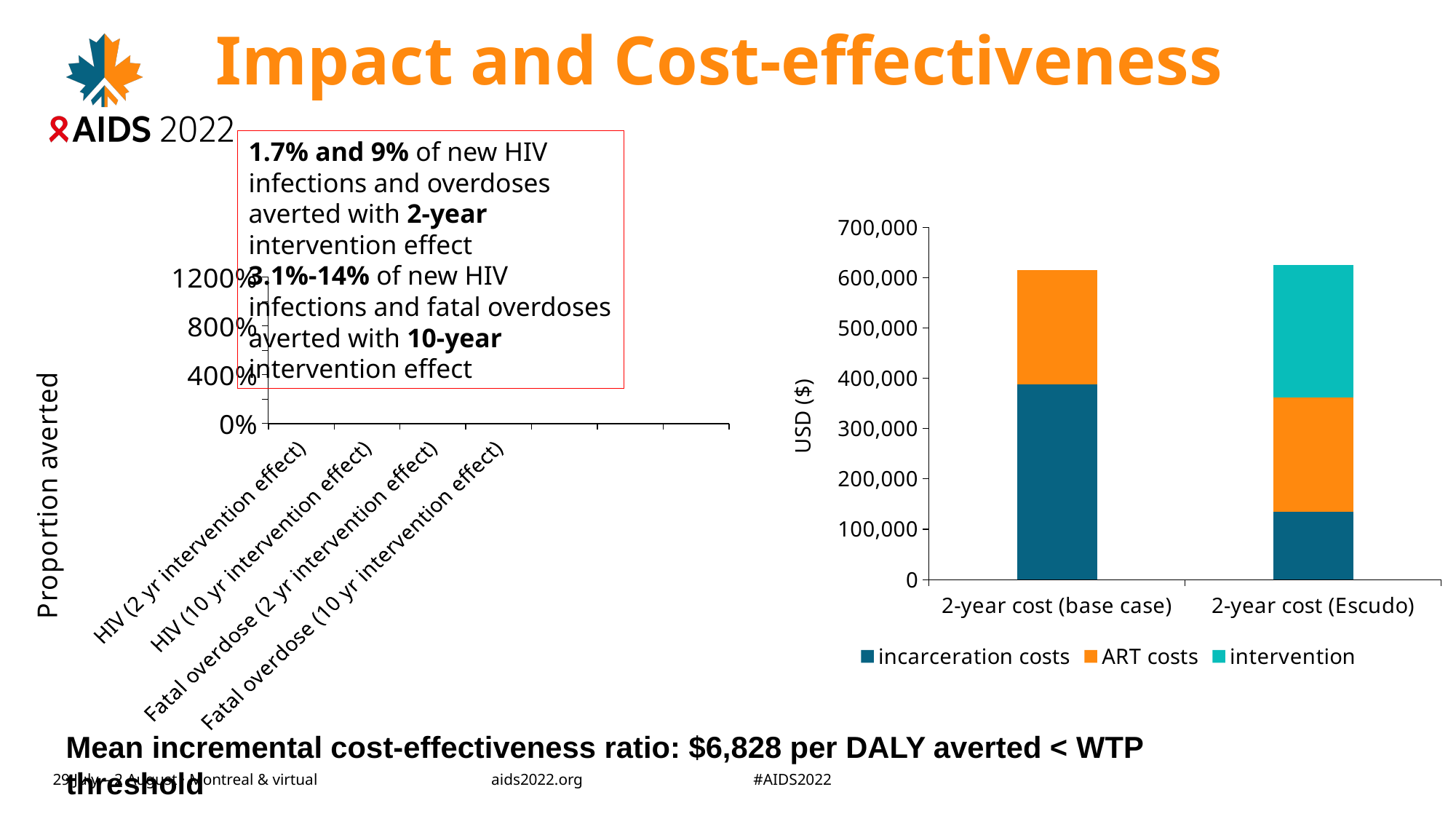
In the right-hand chart (USD ($)), which category has the larger incarceration costs segment: 2-year cost (base case) or 2-year cost (Escudo)? 2-year cost (base case) In the right-hand chart (USD ($)), is the total stacked bar for 2-year cost (base case) greater or less than 500,000? greater What is the y-axis label of the right-hand chart? USD ($) How many categories are listed on the x axis of the left-hand chart (Proportion averted)? 4 In the right-hand chart (USD ($)), is the incarceration costs value for 2-year cost (Escudo) greater or less than 200,000? less How many categories are shown on the x axis of the right-hand chart (USD ($))? 2 In the right-hand chart (USD ($)), is the total stacked bar for 2-year cost (Escudo) greater or less than 700,000? less In the right-hand chart (USD ($)), which category includes an intervention cost segment? 2-year cost (Escudo) What kind of chart is the chart on the right of the slide (USD ($))? stacked bar chart How many series does the legend of the right-hand chart (USD ($)) list? 3